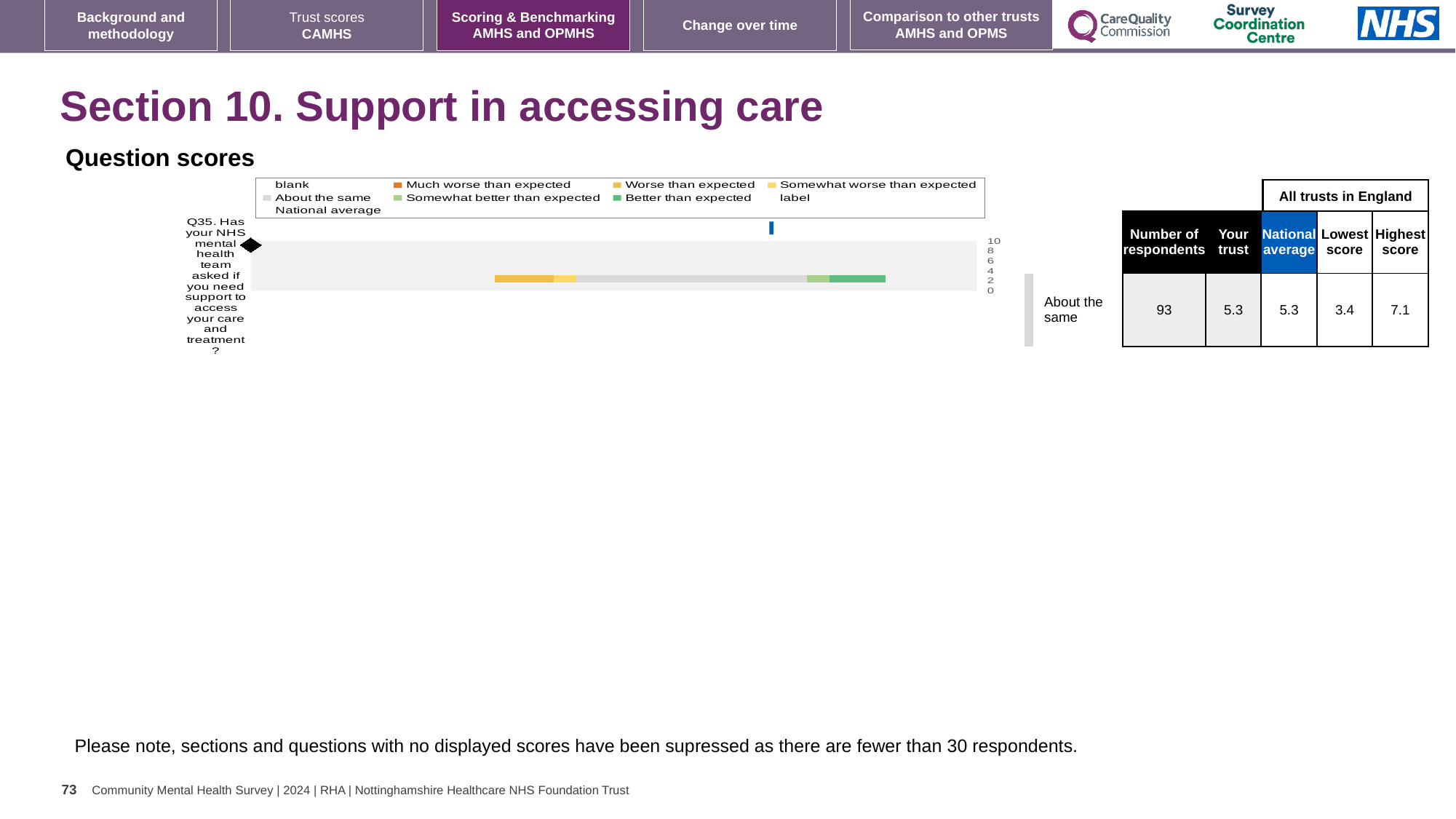
What is the difference between the Highest score and the Lowest score for Q35? 3.7 What is the "Your trust" score for Q35? 5.3 What benchmark category is shown for Q35 in the Question scores chart? About the same What is the maximum value shown on the score axis of the Question scores chart? 10 Is the trust score for Q35 greater or less than 4 on the chart axis? greater How many respondents answered Q35? 93 What is the Highest score among all trusts in England for Q35? 7.1 Which question is plotted in the Question scores chart? Q35. Has your NHS mental health team asked if you need support to access your care and treatment? What is the National average score for Q35? 5.3 What is the Lowest score among all trusts in England for Q35? 3.4 How many questions are plotted in the Question scores chart? 1 What kind of chart is shown under "Question scores"? bar chart